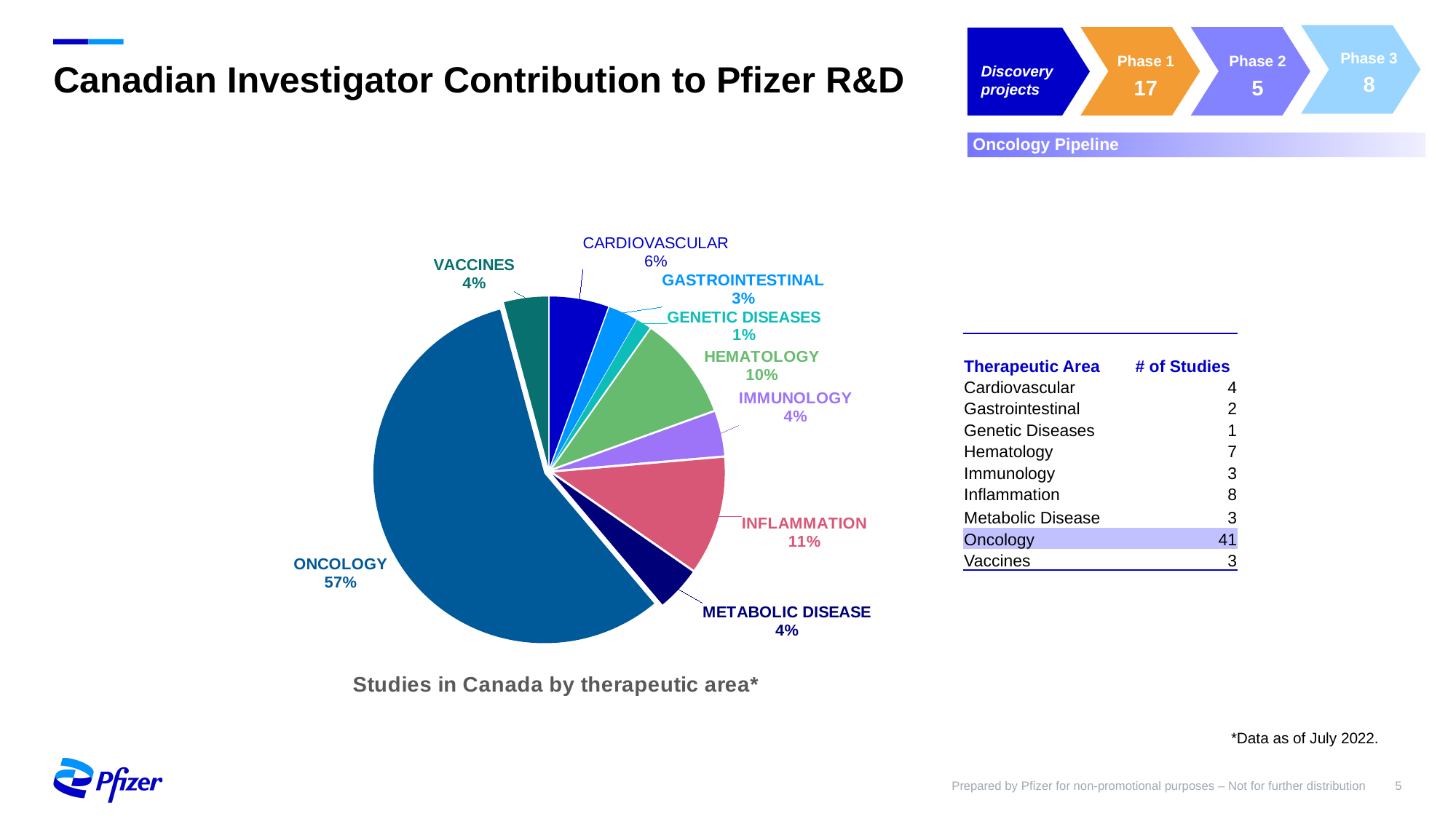
What percentage is shown for Cardiovascular in the pie chart? 6% What type of chart is shown on the slide? pie chart Which therapeutic area has the largest slice of the pie chart? Oncology What is the title of the pie chart? Studies in Canada by therapeutic area* What percentage is shown for Inflammation in the pie chart? 11% Which has a larger share in the pie chart, Hematology or Cardiovascular? Hematology What percentage is shown for Hematology in the pie chart? 10% What percentage is shown for Gastrointestinal in the pie chart? 3% How many therapeutic areas are shown in the pie chart? 9 What share of the pie does Oncology represent? 57% Which therapeutic area has the smallest slice of the pie chart? Genetic Diseases What is the difference in percentage points between Oncology and Inflammation in the pie chart? 46